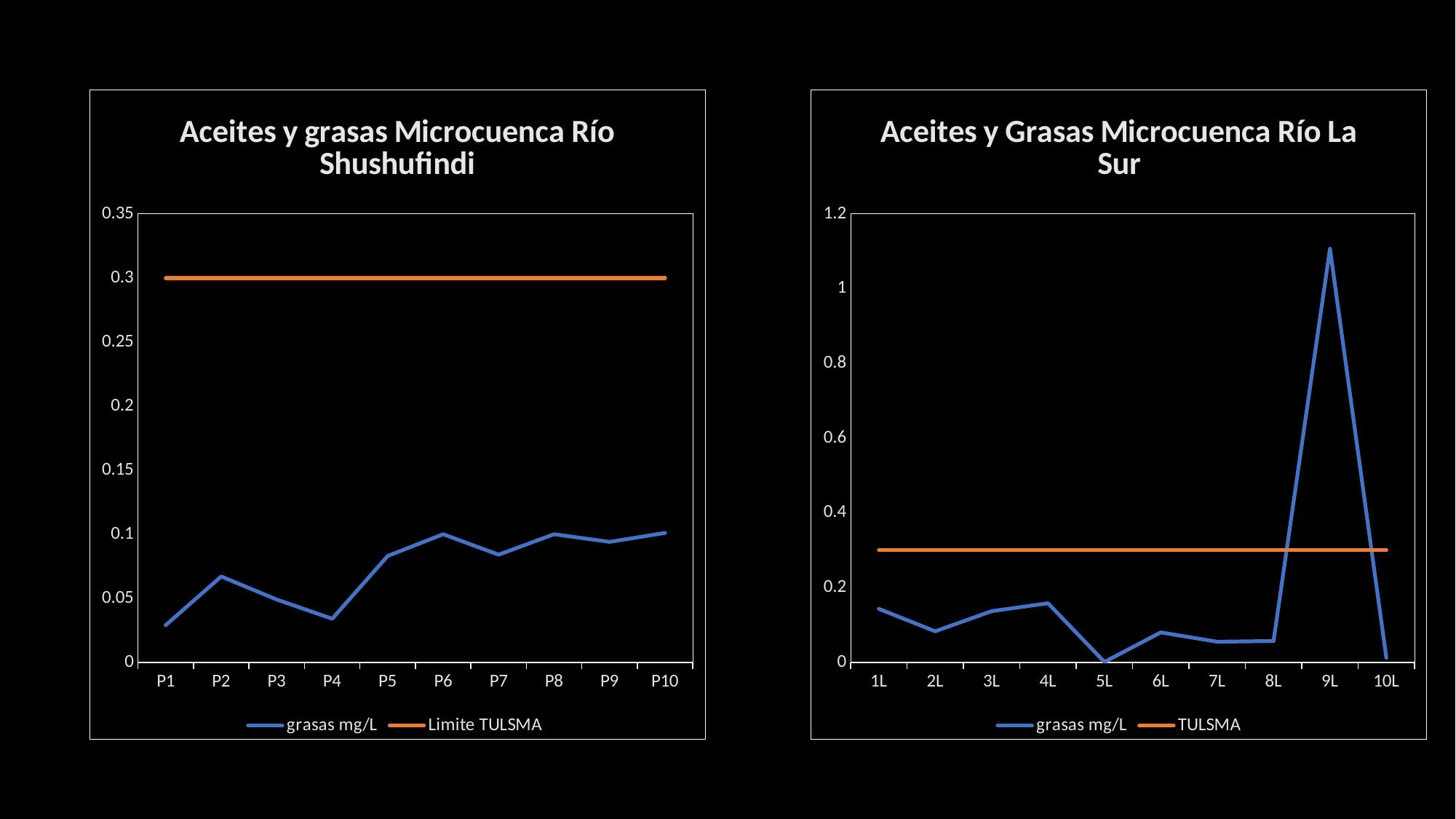
In the 'Aceites y Grasas Microcuenca Río La Sur' chart, which point has the highest grasas mg/L value? 9L How many points are plotted along the x axis of the 'Aceites y Grasas Microcuenca Río La Sur' chart? 10 In the 'Aceites y grasas Microcuenca Río Shushufindi' chart, what value does the Limite TULSMA line sit at? 0.3 In the 'Aceites y grasas Microcuenca Río Shushufindi' chart, is the grasas mg/L value for P6 greater or less than 0.05? greater What kind of chart is the 'Aceites y grasas Microcuenca Río Shushufindi' chart? line chart What colour is the TULSMA line in the 'Aceites y Grasas Microcuenca Río La Sur' chart? orange In the 'Aceites y Grasas Microcuenca Río La Sur' chart, is the grasas mg/L value for 9L greater or less than 1? greater In the 'Aceites y Grasas Microcuenca Río La Sur' chart, which point has the lowest grasas mg/L value? 5L How many series does the legend of the 'Aceites y grasas Microcuenca Río Shushufindi' chart list? 2 In the 'Aceites y Grasas Microcuenca Río La Sur' chart, which has the larger grasas mg/L value, 4L or 9L? 9L In the 'Aceites y grasas Microcuenca Río Shushufindi' chart, is the grasas mg/L value for P1 greater or less than 0.05? less In the 'Aceites y grasas Microcuenca Río Shushufindi' chart, which has the larger grasas mg/L value, P2 or P4? P2